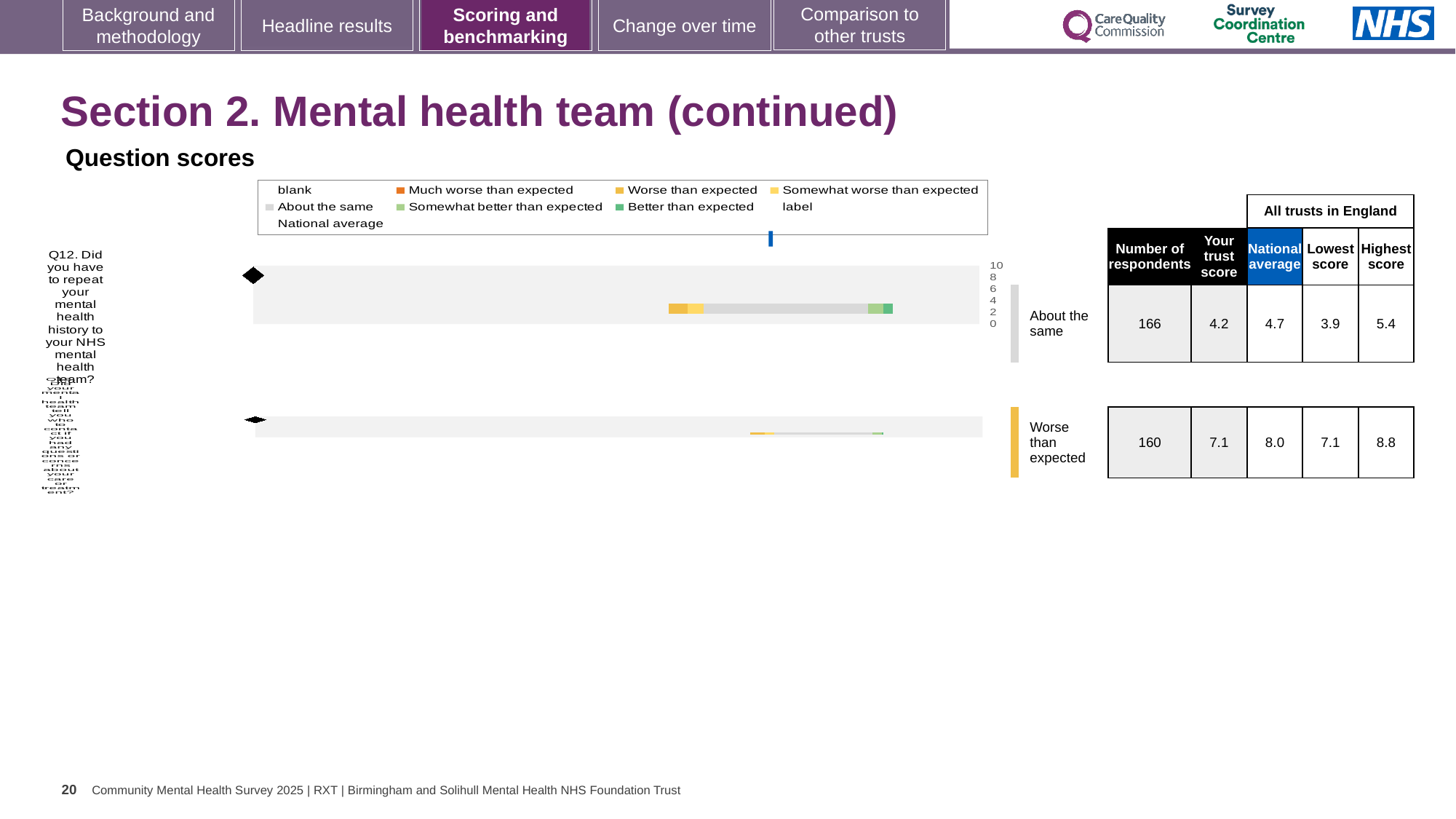
In the table beside the chart, what is the lowest score among all trusts for the question rated 'Worse than expected'? 7.1 In the table beside the chart, what is the highest score among all trusts in England for Q12? 5.4 For the question rated 'Worse than expected', which is larger: your trust score or the national average? national average In the table beside the chart, what is the national average for Q12? 4.7 What kind of chart is shown under 'Question scores'? bar chart In the table beside the chart, what is the difference between the national average and your trust score for Q12? 0.5 How many questions are plotted as bars in the chart? 2 In the table beside the chart, what is the number of respondents for Q12? 166 What benchmark category is shown next to the bar for Q12 (repeating mental health history)? About the same What benchmark category is shown next to the second (lower) bar in the chart? Worse than expected In the table beside the chart, what is 'Your trust score' for Q12? 4.2 Which legend entry in the chart is shown in orange? Much worse than expected